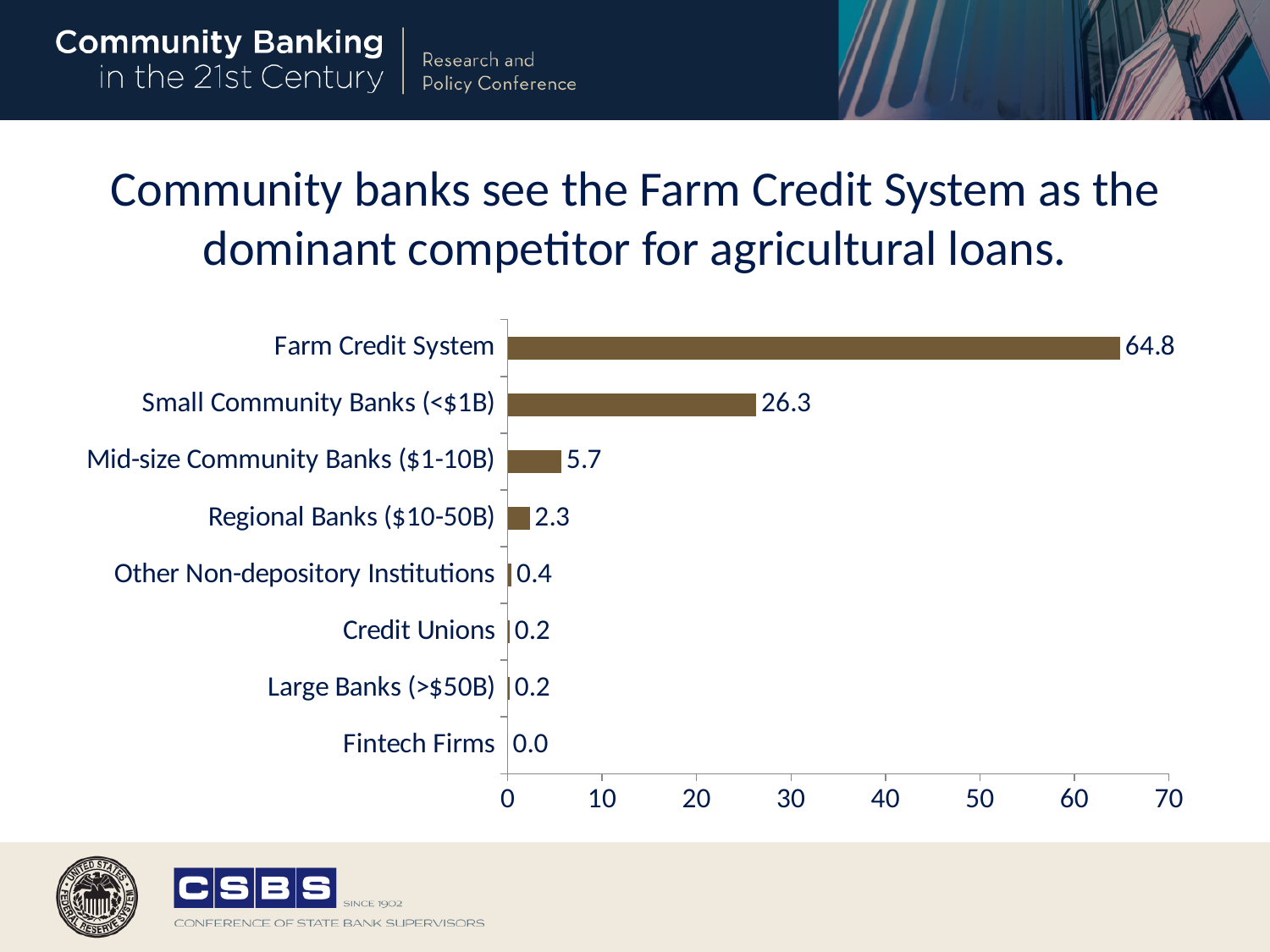
Which category has the lowest value? Fintech Firms Which category has the highest value? Farm Credit System What is the value for Fintech Firms? 0.0 What kind of chart is shown on the slide? Bar chart What is the value for Mid-size Community Banks ($1-10B)? 5.7 What is the value for Regional Banks ($10-50B)? 2.3 What is the value for Small Community Banks (<$1B)? 26.3 Is the value for Farm Credit System greater or less than 60? greater What is the value for Farm Credit System? 64.8 How many categories are shown in the chart? 8 What is the difference between the values for Farm Credit System and Small Community Banks (<$1B)? 38.5 Which is larger, the value for Mid-size Community Banks ($1-10B) or Regional Banks ($10-50B)? Mid-size Community Banks ($1-10B)